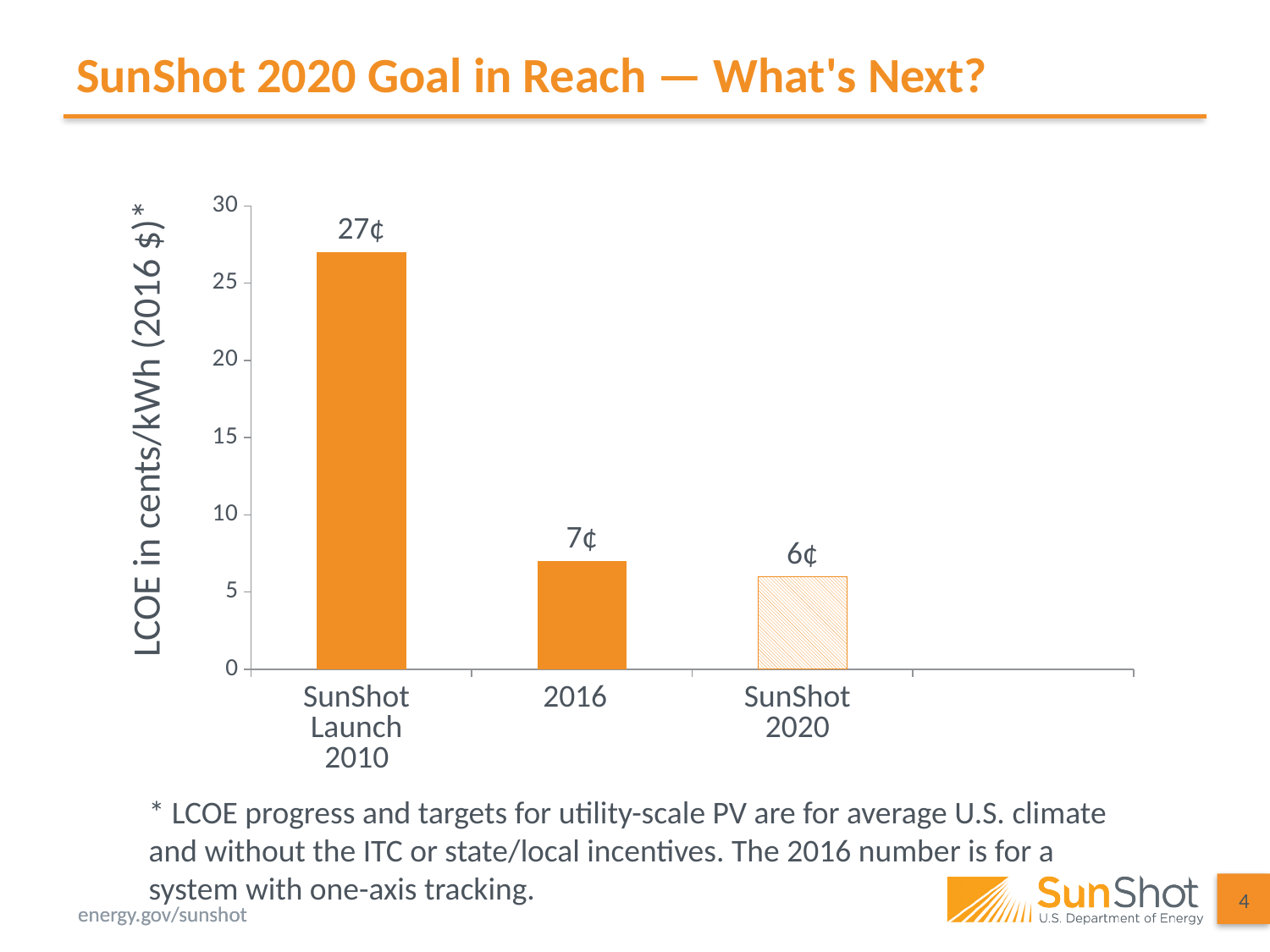
What is the difference between the LCOE for SunShot Launch 2010 and 2016? 20¢ Is the value for SunShot Launch 2010 greater or less than 25? greater Which category has the lowest LCOE value? SunShot 2020 What is the LCOE value for 2016? 7¢ What is the LCOE value for SunShot Launch 2010? 27¢ What is the LCOE value for SunShot 2020? 6¢ How many categories are shown on the x axis? 3 What is the label of the vertical axis? LCOE in cents/kWh (2016 $)* What kind of chart is shown on the slide? bar chart Which category has the highest LCOE value? SunShot Launch 2010 Which is larger, the LCOE for SunShot Launch 2010 or for 2016? SunShot Launch 2010 What is the difference between the LCOE for 2016 and SunShot 2020? 1¢